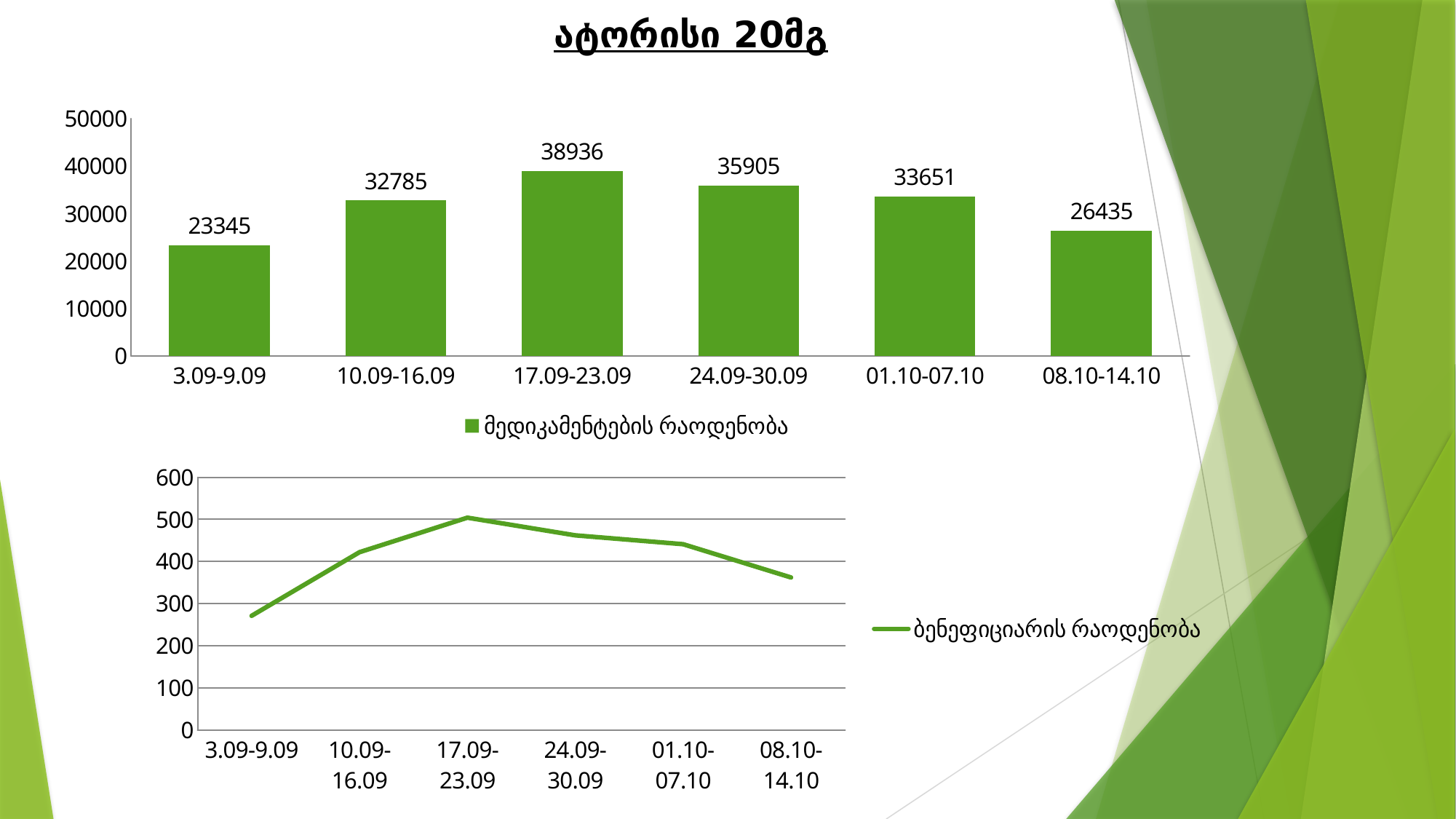
In the top bar chart, what is the value for 3.09-9.09? 23345 In the top bar chart, what is the value for 08.10-14.10? 26435 In the top bar chart, which period has the highest value? 17.09-23.09 In the bottom line chart, is the value for 08.10-14.10 greater or less than 400? less What is the legend entry of the bottom line chart? ბენეფიციარის რაოდენობა In the top bar chart, what is the value for 17.09-23.09? 38936 In the top bar chart, which is larger: the value for 10.09-16.09 or the value for 01.10-07.10? 01.10-07.10 In the top bar chart, which period has the lowest value? 3.09-9.09 How many periods are shown on the x axis of the top bar chart? 6 In the bottom line chart, is the value for 3.09-9.09 greater or less than 300? less In the top bar chart, what is the difference between the values for 17.09-23.09 and 24.09-30.09? 3031 What kind of chart is the bottom chart on the slide? line chart